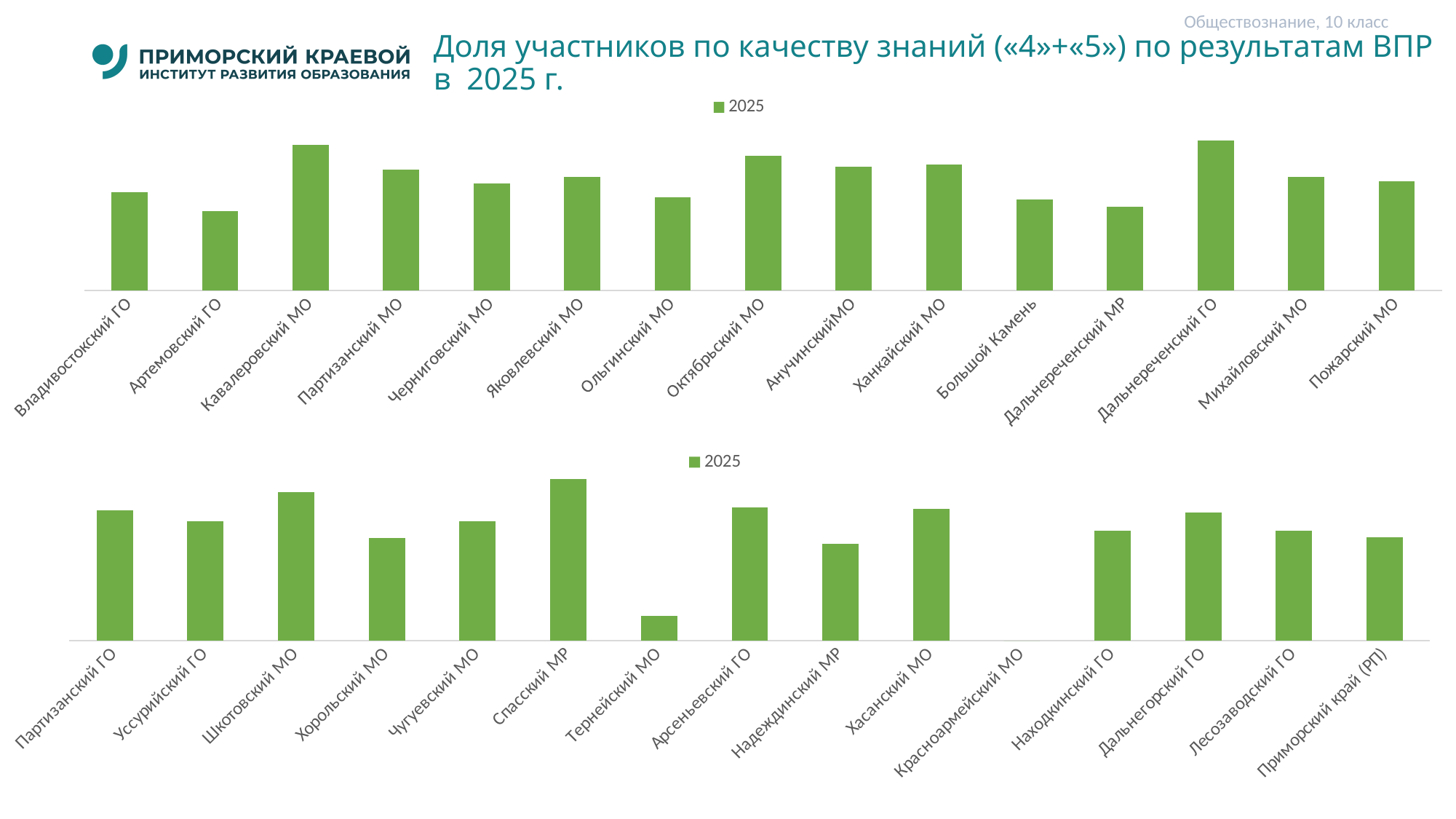
What series name is shown in the legend of the bottom chart? 2025 In the top chart, which category has the lowest value? Артемовский ГО How many categories are shown in the bottom chart? 15 In the bottom chart, which category has no bar shown? Красноармейский МО In the bottom chart, which is larger: the value for Арсеньевский ГО or for Надеждинский МР? Арсеньевский ГО In the top chart, which is larger: the value for Кавалеровский МО or for Ольгинский МО? Кавалеровский МО In the bottom chart, which category has the highest value? Спасский МР How many series does the legend of the top chart list? 1 In the bottom chart, which is larger: the value for Шкотовский МО or for Хорольский МО? Шкотовский МО In the top chart, which category has the highest value? Дальнереченский ГО How many categories are shown in the top chart? 15 What kind of chart is the top chart on the slide? bar chart